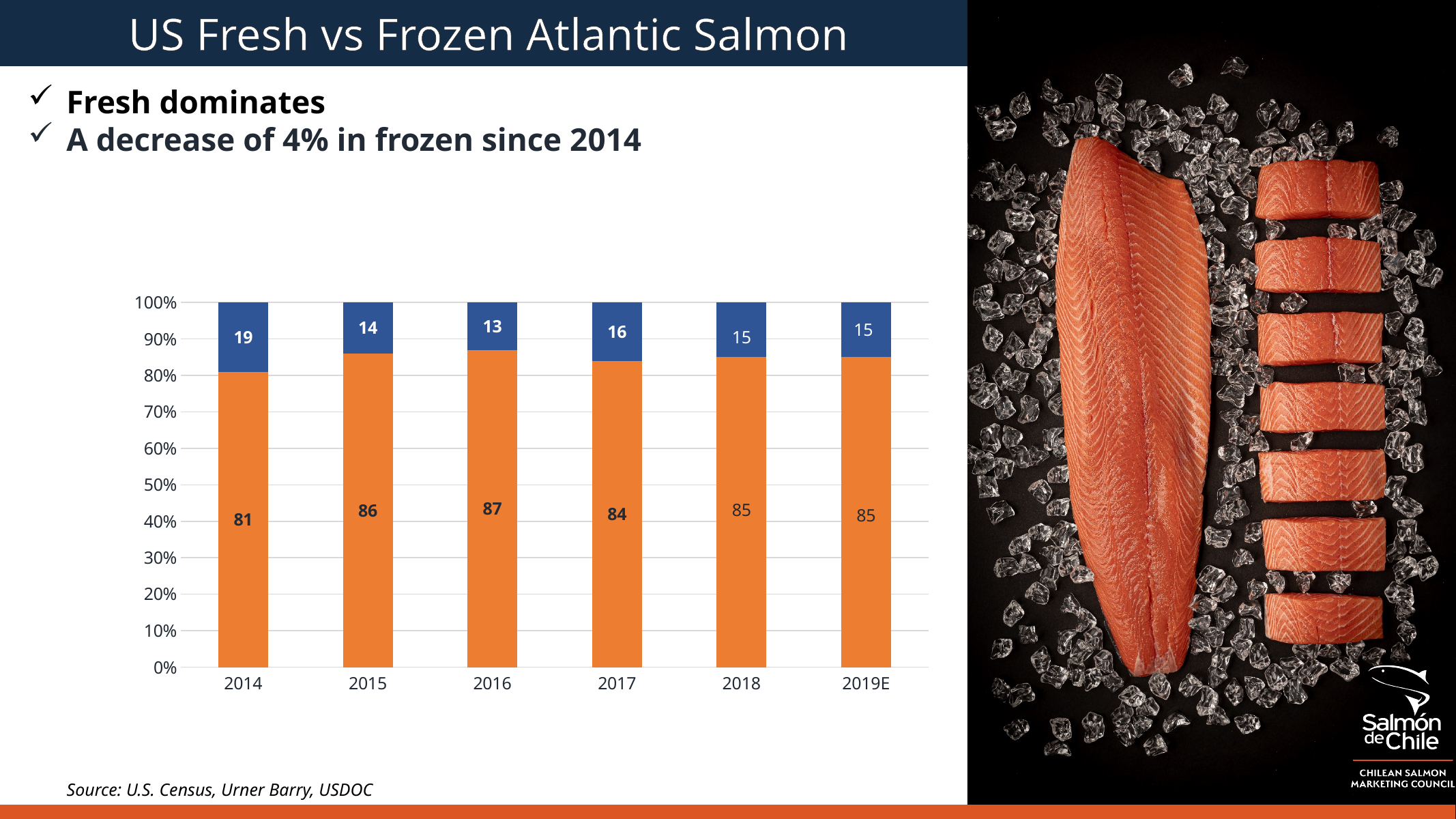
How many years are shown on the x axis? 6 In which year is the blue (top) segment the largest? 2014 In which year is the orange (bottom) segment the smallest? 2014 What is the value of the blue (top) segment for 2017? 16 What is the title of the slide containing the chart? US Fresh vs Frozen Atlantic Salmon What is the value of the blue segment for 2016? 13 What is the value of the orange (bottom) segment for 2014? 81 What is the difference between the blue segment values for 2014 and 2015? 5 Which year has a larger orange segment, 2015 or 2017? 2015 In which year is the orange segment the largest? 2016 What is the value of the orange segment for 2019E? 85 What kind of chart is shown on the slide? Stacked bar chart